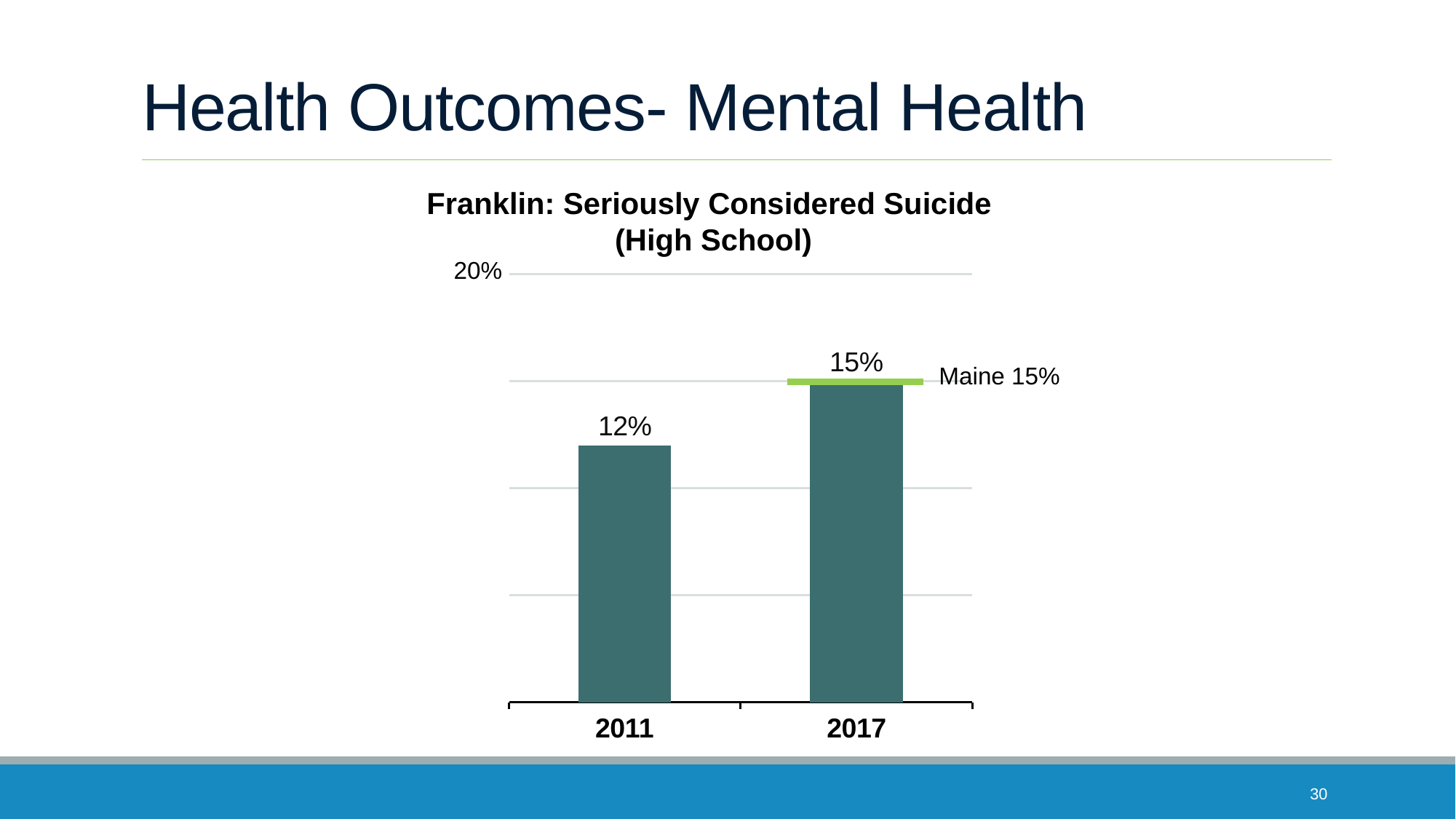
What is the value for 2011? 12% What is the Maine value marked by the green line? 15% Do the values rise or fall from 2011 to 2017? rise What kind of chart is this? bar chart Which year has the lower value? 2011 What is the title of the chart? Franklin: Seriously Considered Suicide (High School) What is the value for 2017? 15% Which year has the higher value? 2017 What is the difference between the 2017 and 2011 values? 3% Is the value for 2017 larger or smaller than the value for 2011? larger How many years are shown on the x axis? 2 Is the value for 2011 greater or less than 20%? less